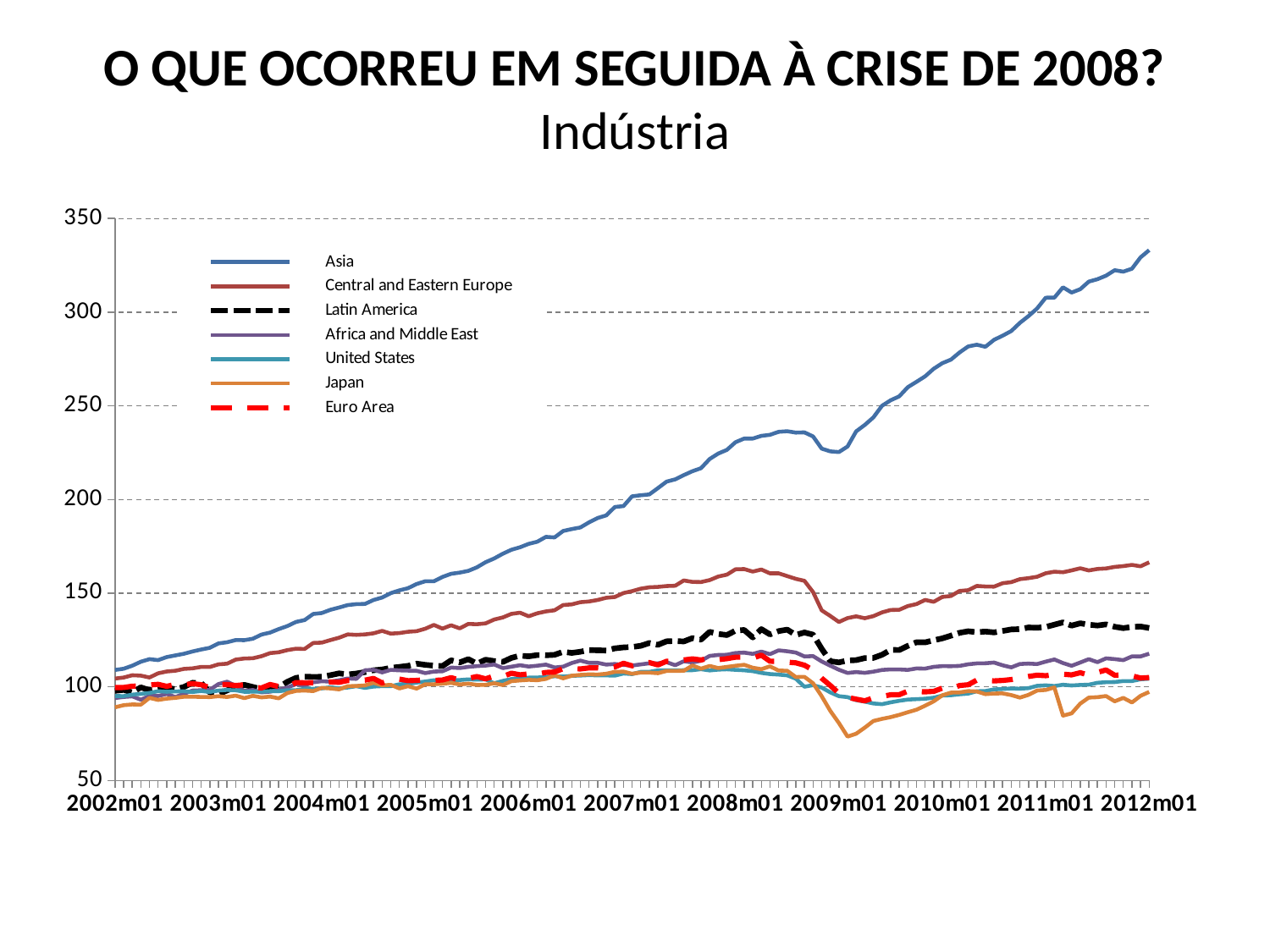
Is the value for Asia at 2002m01 greater or less than 150? less Is the value for Central and Eastern Europe at 2012m01 greater or less than 150? greater Does the Asia series generally rise or fall from 2002m01 to 2012m01? rise At 2012m01, which is larger: Asia or Central and Eastern Europe? Asia Is the value for Asia at 2012m01 greater or less than 300? greater What kind of chart is shown on the slide? line chart Which series reaches the highest value at the end of the period (2012m01)? Asia What is the subtitle of the chart on the slide? Indústria Which series dips to the lowest value during 2009? Japan Which series is drawn as a red dashed line? Euro Area How many series does the legend list? 7